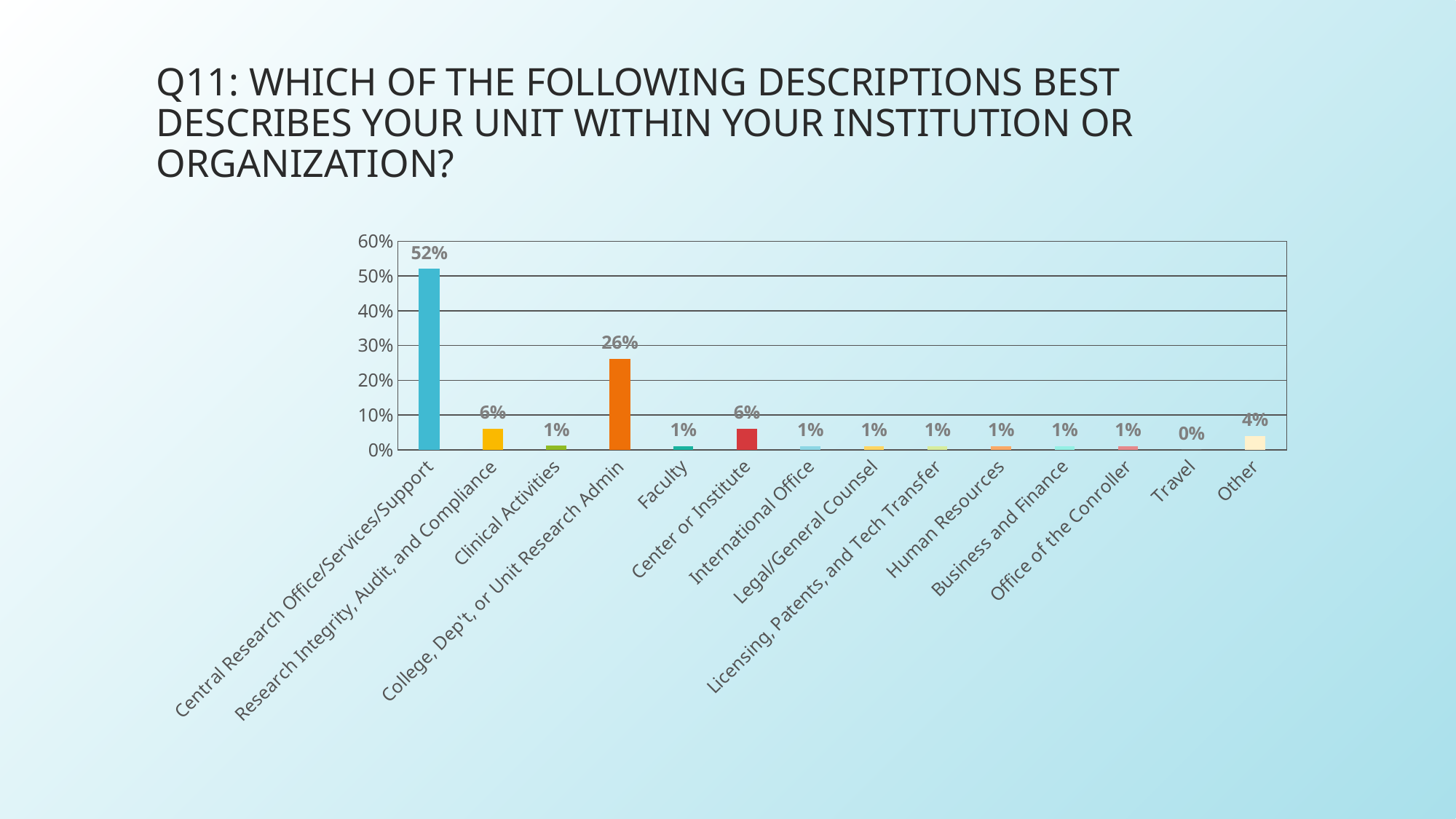
Which category has the lowest value? Travel What percentage is shown for Other? 4% What is the value for Travel? 0% How many categories are shown on the x axis? 14 What is the difference between Central Research Office/Services/Support and College, Dep't, or Unit Research Admin? 26% What percentage of respondents selected Central Research Office/Services/Support? 52% What is the value for College, Dep't, or Unit Research Admin? 26% Which category has the highest value? Central Research Office/Services/Support What kind of chart is shown on the slide? bar chart Which is larger, the value for Research Integrity, Audit, and Compliance or the value for Other? Research Integrity, Audit, and Compliance Is the value for Central Research Office/Services/Support greater or less than 50%? greater What is the maximum value shown on the y axis? 60%